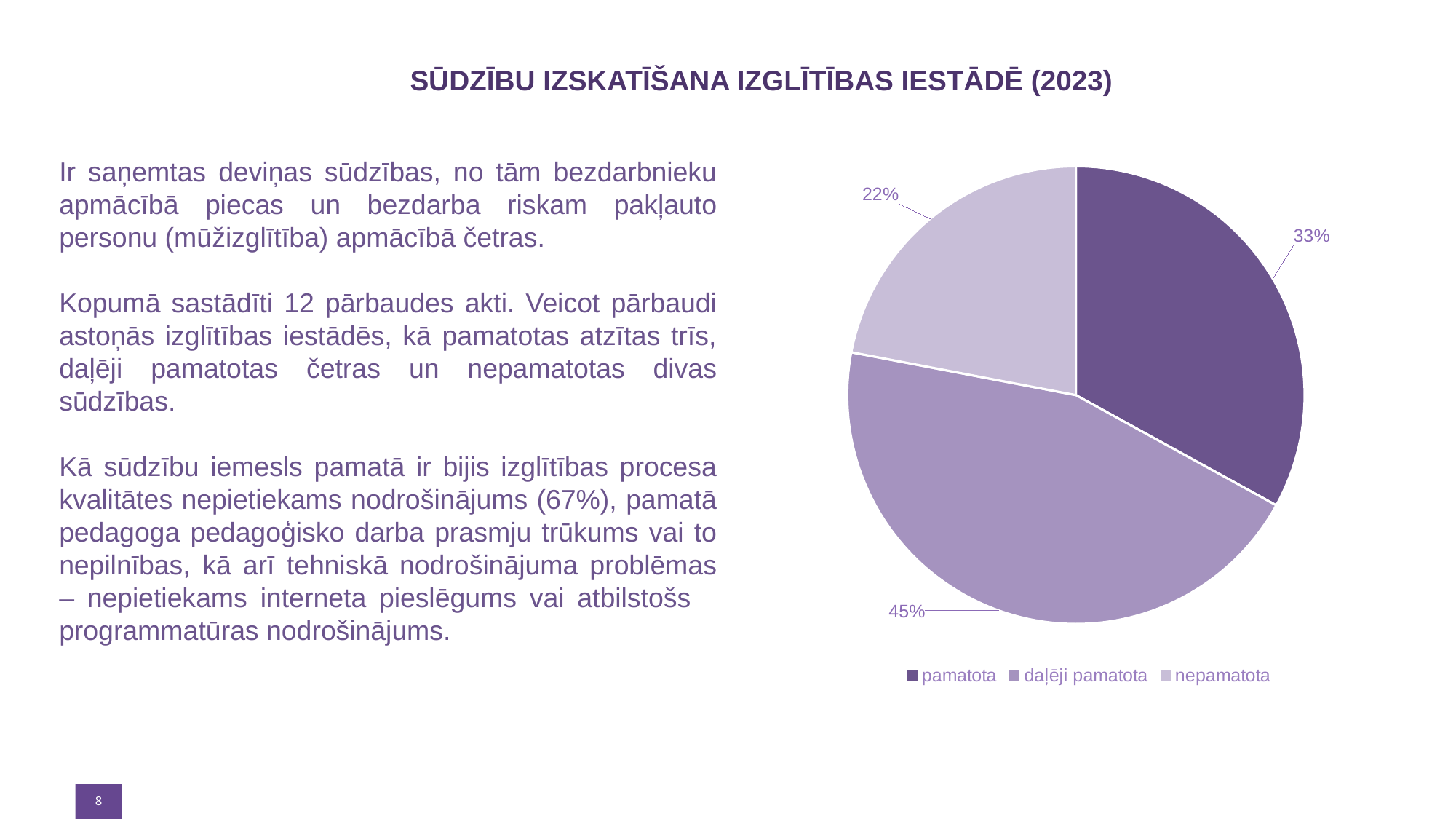
Which category has the smallest slice of the pie? nepamatota What share of the pie does the "nepamatota" slice represent? 22% How many slices does the pie chart have? 3 How many entries does the legend list? 3 What share of the pie does the "daļēji pamatota" slice represent? 45% What kind of chart is shown on the slide? pie chart What is the difference in percentage points between the "pamatota" and "nepamatota" slices? 11 Which slice is larger, "pamatota" or "nepamatota"? pamatota Which legend entry is shown in the darkest purple colour? pamatota Which category has the largest slice of the pie? daļēji pamatota What share of the pie does the "pamatota" slice represent? 33% What is the difference in percentage points between the "daļēji pamatota" and "pamatota" slices? 12